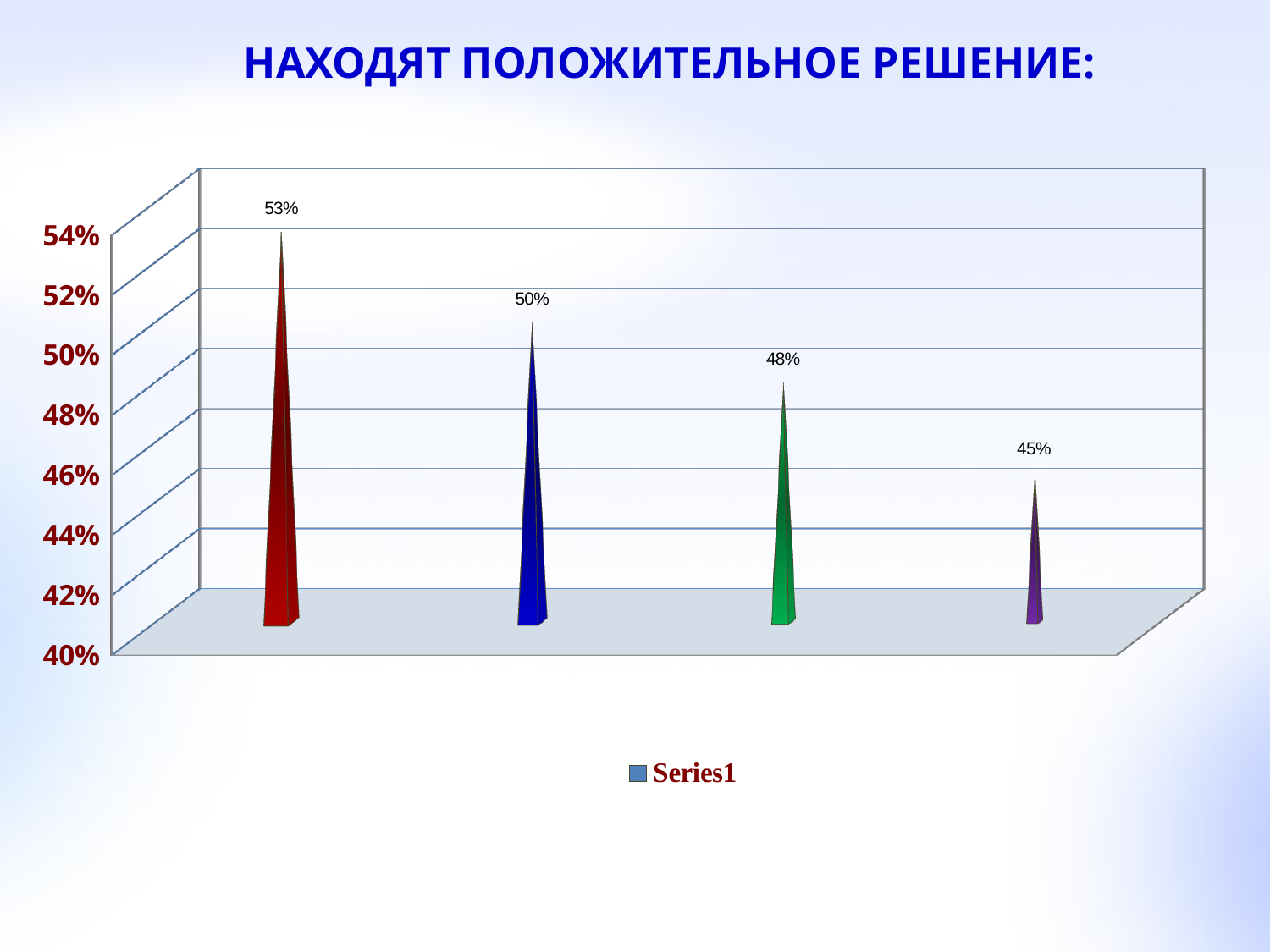
Which bar has the highest value? The first (leftmost) bar, 53% How many bars are plotted on the chart? 4 How many series does the legend list? 1 Which bar has the lowest value? The rightmost bar, 45% What is the value shown for the rightmost bar? 45% What is the value shown for the second bar from the left? 50% What kind of chart is shown on the slide? Bar chart What is the difference between the leftmost bar's value and the rightmost bar's value? 8% Which is larger: the value of the second bar or the value of the third bar? The second bar (50%) What is the value shown for the third bar from the left? 48% What is the value shown for the first (leftmost) bar? 53% Do the values rise or fall from left to right across the chart? Fall